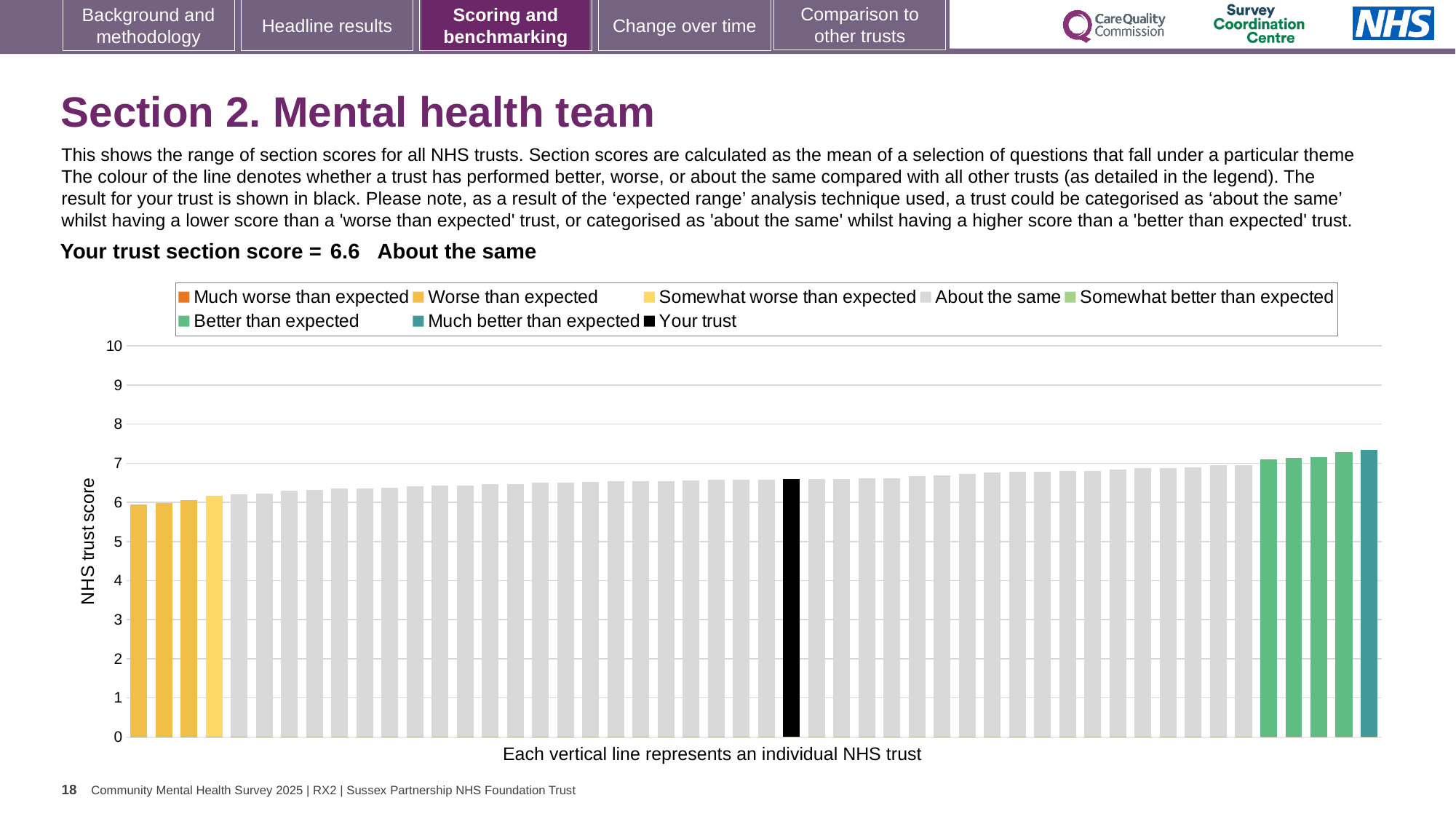
What is the label on the vertical axis of the chart? NHS trust score Do the bar values rise or fall moving from left to right along the x axis? Rise What does the text below the x axis say each vertical line represents? An individual NHS trust What is the highest value shown on the vertical axis of the chart? 10 Is the value of the shortest bar in the chart greater or less than 5? greater Which is larger: the black 'Your trust' bar or the rightmost bar in the chart? The rightmost bar What is the section score for your trust shown on the slide? 6.6 Is the value of the black 'Your trust' bar greater or less than 5? greater Which category is your trust's section score placed in? About the same Is the value of the tallest bar in the chart greater or less than 7? greater How many entries does the chart legend list? 8 What kind of chart is shown on the slide? Bar chart